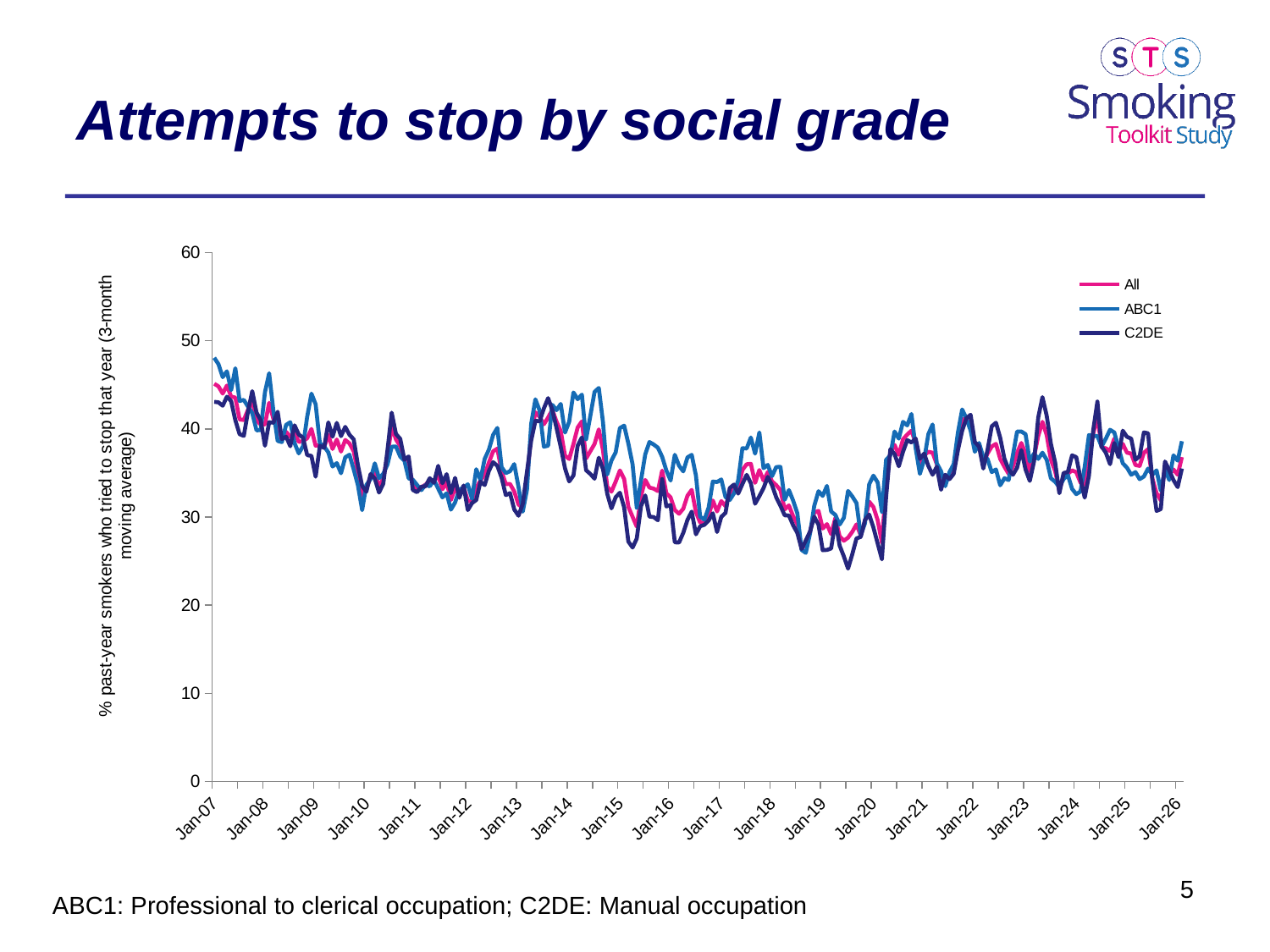
Is the value for All at Jan-10 greater or less than 40? less At Jan-20, which is higher, ABC1 or C2DE? ABC1 Is the value for C2DE at Jan-20 greater or less than 30? less How many year labels are shown on the x axis? 20 Which series has the highest value at Jan-07? ABC1 Is the value for ABC1 at Jan-07 greater or less than 40? greater How many series does the legend list? 3 Overall, do the values rise or fall from Jan-07 to Jan-26? fall What are the three series named in the legend? All, ABC1, C2DE What is the title of the slide's chart? Attempts to stop by social grade What kind of chart is shown on the slide? Line chart